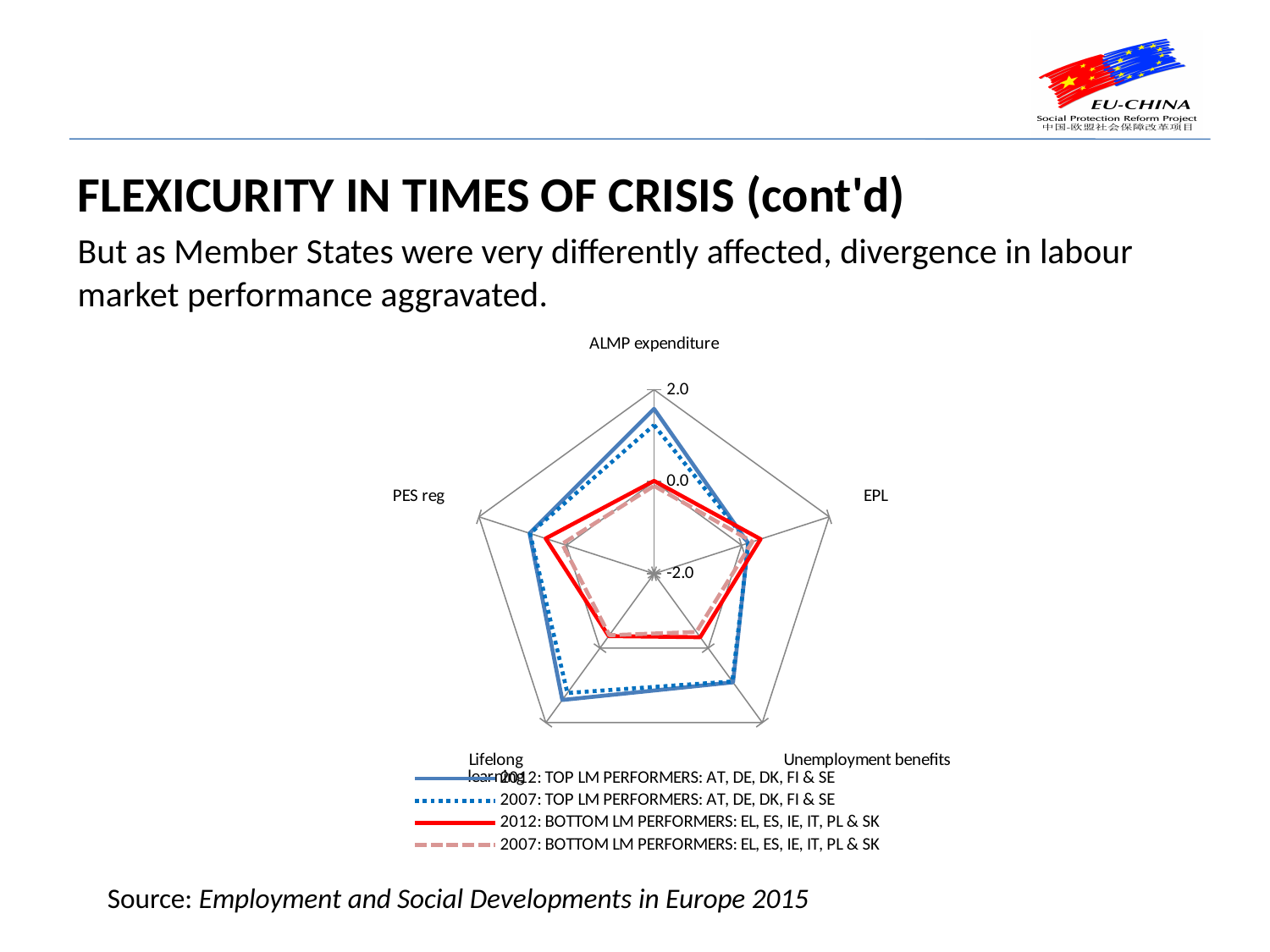
What kind of chart is shown on the slide? Radar chart Is the PES reg value for 2012: TOP LM PERFORMERS greater or less than 0.0? greater Is the Lifelong learning value for 2012: BOTTOM LM PERFORMERS greater or less than 0.0? less Which has the higher Unemployment benefits value, 2012: TOP LM PERFORMERS or 2012: BOTTOM LM PERFORMERS? 2012: TOP LM PERFORMERS Is the ALMP expenditure value for 2012: TOP LM PERFORMERS greater or less than 0.0? greater Which category is plotted on the top axis of the radar chart? ALMP expenditure Which countries make up the BOTTOM LM PERFORMERS group in the legend? EL, ES, IE, IT, PL & SK Which has the higher ALMP expenditure value, 2012: TOP LM PERFORMERS or 2012: BOTTOM LM PERFORMERS? 2012: TOP LM PERFORMERS How many axes (categories) does the radar chart have? 5 How many series does the legend list? 4